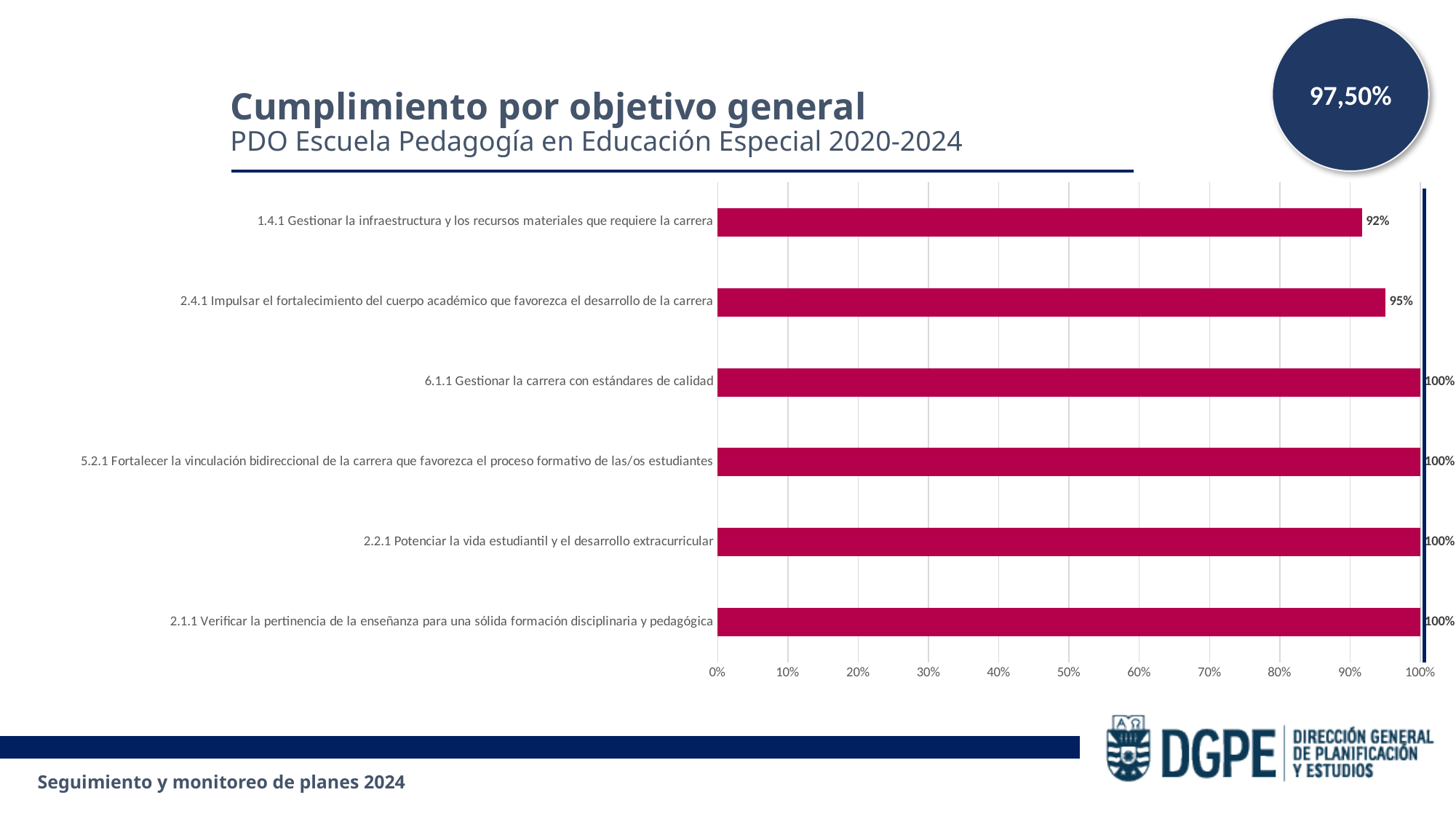
Which is larger, the value for objective 2.4.1 or the value for objective 1.4.1? 2.4.1 How many objectives have a value of 100%? 4 How many objectives are shown in the chart? 6 What is the value for objective 1.4.1 Gestionar la infraestructura y los recursos materiales que requiere la carrera? 92% What is the title of the chart on the slide? Cumplimiento por objetivo general What is the difference between the values for objective 2.4.1 and objective 1.4.1? 3% Which objective has the lowest value in the chart? 1.4.1 Gestionar la infraestructura y los recursos materiales que requiere la carrera What kind of chart is shown on the slide? Bar chart What is the value for objective 2.2.1 Potenciar la vida estudiantil y el desarrollo extracurricular? 100% What is the value for objective 2.4.1 Impulsar el fortalecimiento del cuerpo académico que favorezca el desarrollo de la carrera? 95% What is the difference between the values for objective 6.1.1 and objective 1.4.1? 8% Is the value for objective 1.4.1 greater or less than 90%? greater